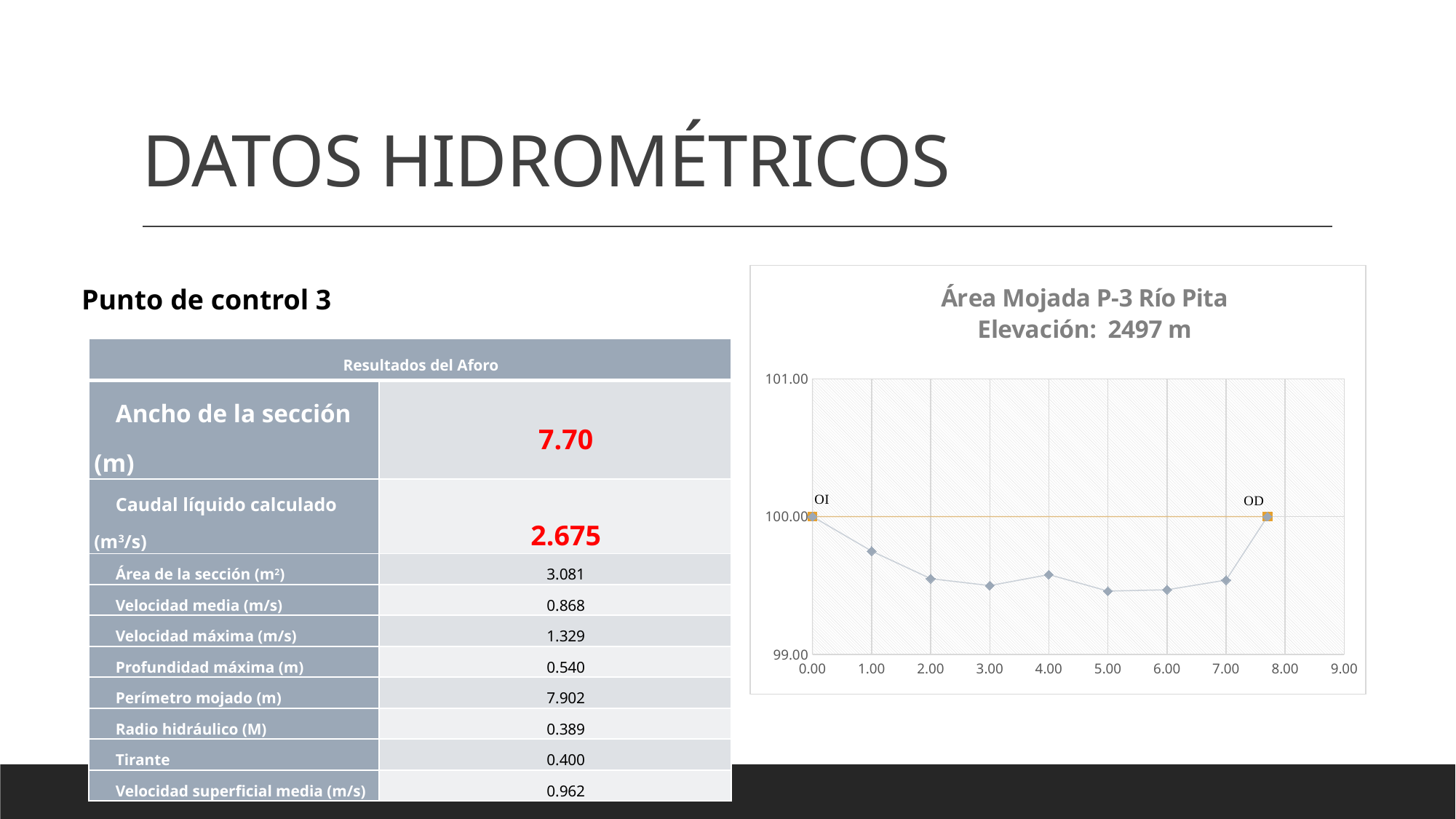
Is the value at x = 3.00 greater or less than 100.00? less What is the plotted value at the point labelled OD? 100.00 Is the value at x = 5.00 greater or less than 99.00? greater What is the plotted value at x = 0.00 (the point labelled OI)? 100.00 What kind of chart is shown on the slide? line chart What is the highest tick value shown on the x axis? 9.00 How many data points are plotted on the line? 9 What elevation is stated in the chart title? 2497 m Which is larger, the value at x = 1.00 or the value at x = 5.00? x = 1.00 What is the title of the chart on the slide? Área Mojada P-3 Río Pita Elevación: 2497 m Do the values rise or fall along the x axis from x = 0.00 to x = 5.00? fall Do the values rise or fall along the x axis from x = 6.00 to the OD point? rise